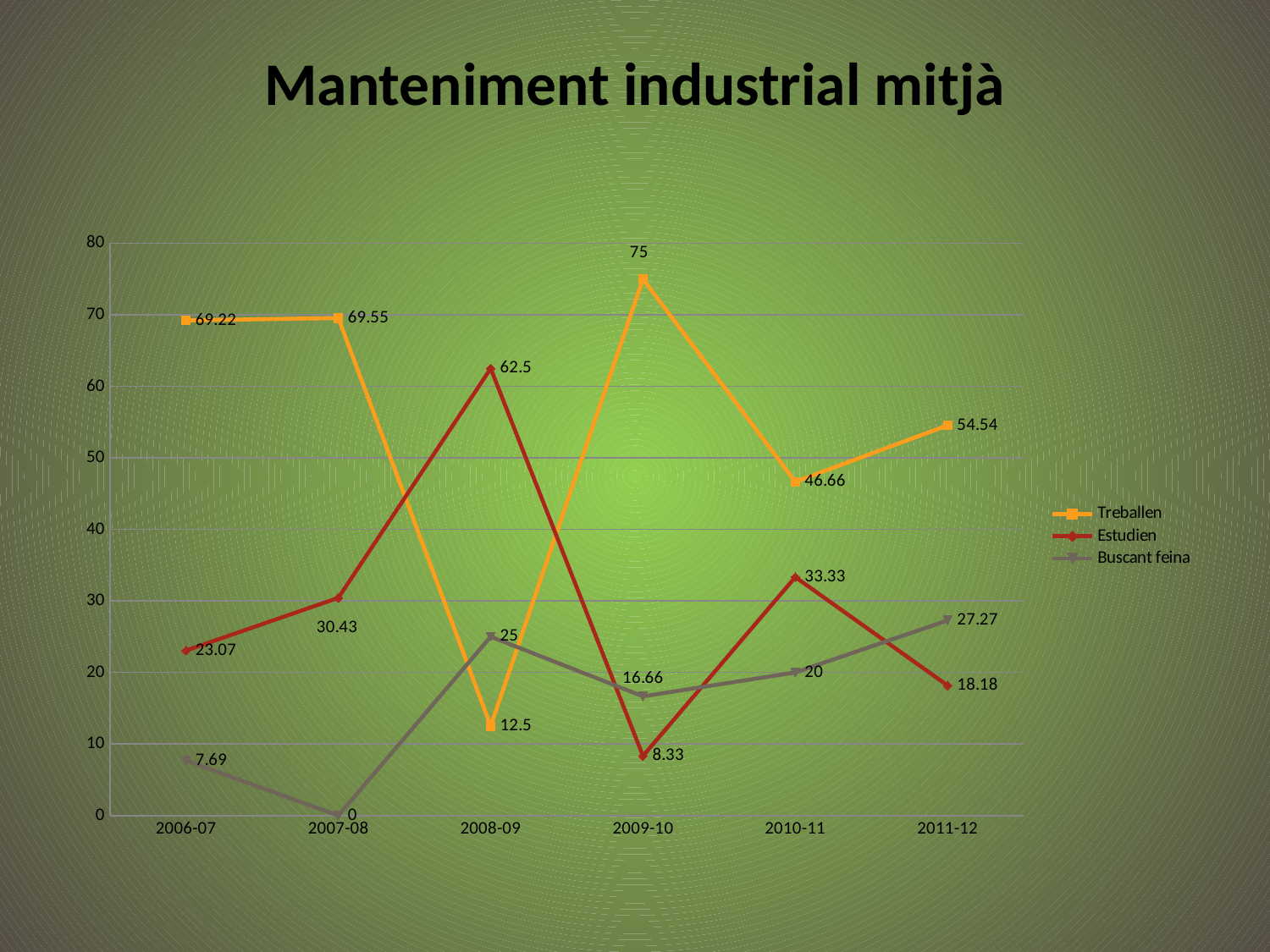
What kind of chart is shown on the slide? line chart What is the value for Buscant feina in 2007-08? 0 How many academic years are shown on the x axis? 6 In 2010-11, which is larger: Estudien or Buscant feina? Estudien What is the value for Estudien in 2008-09? 62.5 Is the value for Treballen in 2010-11 greater or less than 50? less How many series does the legend list? 3 What is the value for Treballen in 2009-10? 75 Does the Buscant feina series rise or fall from 2009-10 to 2011-12? rise In which year is the Estudien series at its lowest? 2009-10 In which year is the Treballen series at its highest? 2009-10 What is the difference between Treballen and Estudien in 2009-10? 66.67